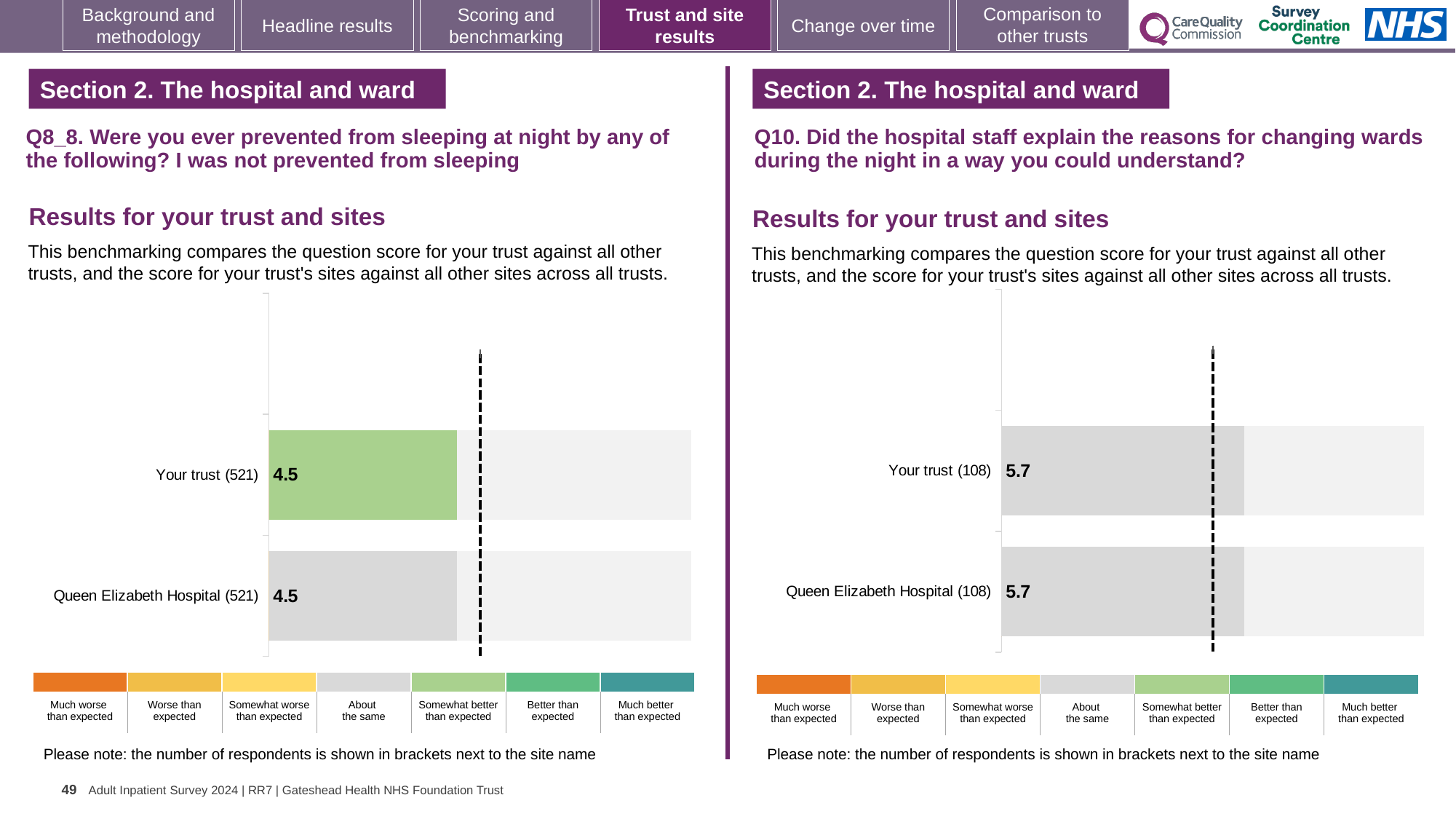
How many bars are plotted in the left chart (Q8_8)? 2 What type of chart is used in the left chart (Q8_8)? Bar chart In the left chart (Q8_8), what is the difference between the score for Your trust and the score for Queen Elizabeth Hospital? 0 In the right chart (Q10), how many respondents are shown in brackets for Queen Elizabeth Hospital? 108 In the left chart (Q8_8), what is the score for Your trust? 4.5 In the right chart (Q10), what is the score for Your trust? 5.7 In the left chart (Q8_8), which benchmark category does the colour of the Your trust bar correspond to in the legend? Somewhat better than expected How many bars are plotted in the right chart (Q10)? 2 In the left chart (Q8_8), what is the score for Queen Elizabeth Hospital? 4.5 In the left chart (Q8_8), how many respondents are shown in brackets for Your trust? 521 In the right chart (Q10), what is the score for Queen Elizabeth Hospital? 5.7 In the right chart (Q10), what is the difference between the score for Your trust and the score for Queen Elizabeth Hospital? 0